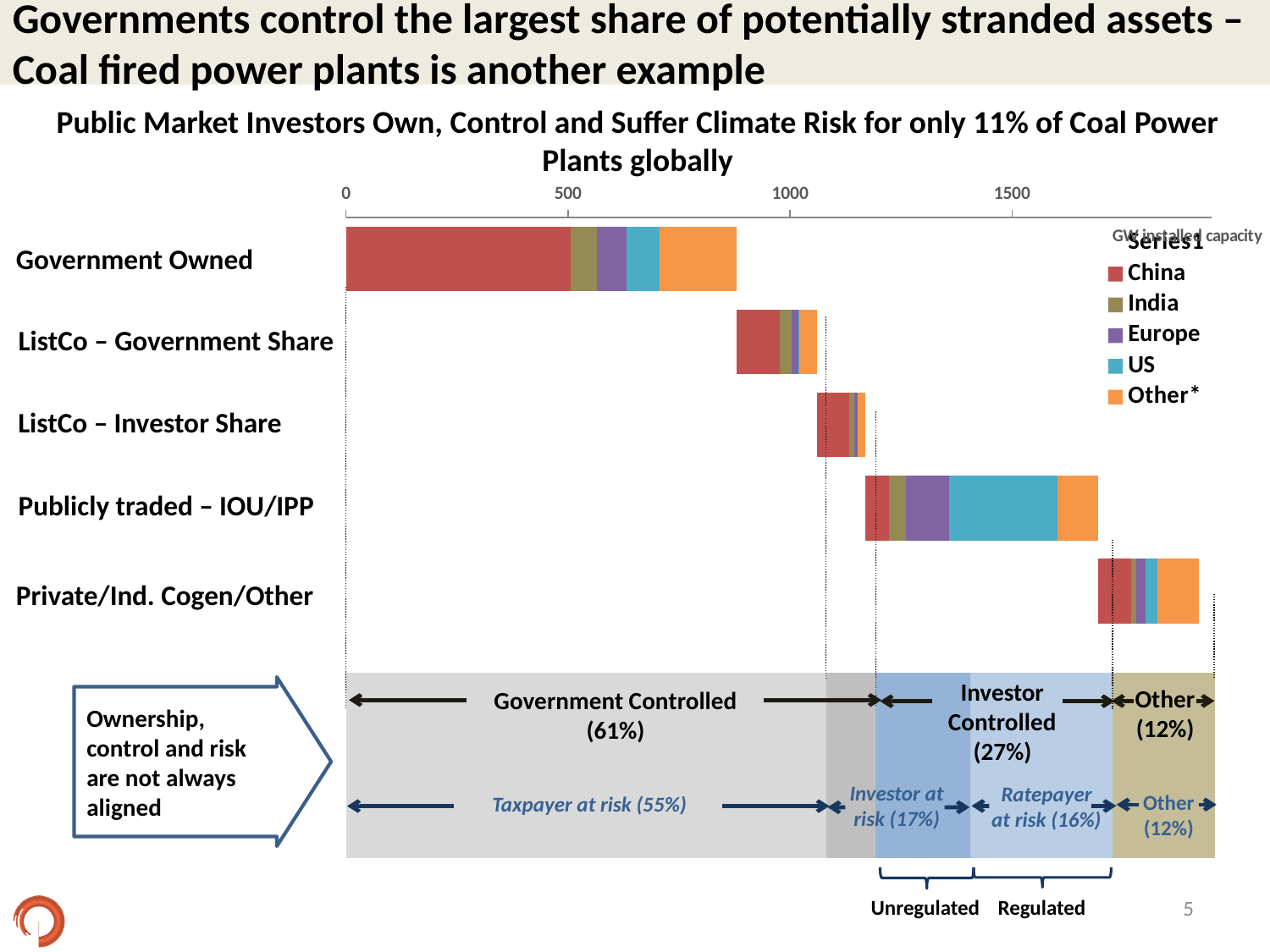
Is the total for Government Owned greater or less than 1000? less What kind of chart is shown on the slide? Bar chart How many ownership categories are plotted on the chart? 5 Is the total for Government Owned greater or less than 500? greater How many entries does the chart legend list? 6 What percentage is labelled as Investor Controlled on the chart? 27% What unit is given for the horizontal axis of the chart? GW installed capacity Which bar is larger, Government Owned or Publicly traded – IOU/IPP? Government Owned Which bar is larger, ListCo – Government Share or ListCo – Investor Share? ListCo – Government Share What percentage of coal power plants is labelled as Government Controlled on the chart? 61% Which ownership category has the largest bar on the chart? Government Owned Which ownership category has the smallest bar on the chart? ListCo – Investor Share